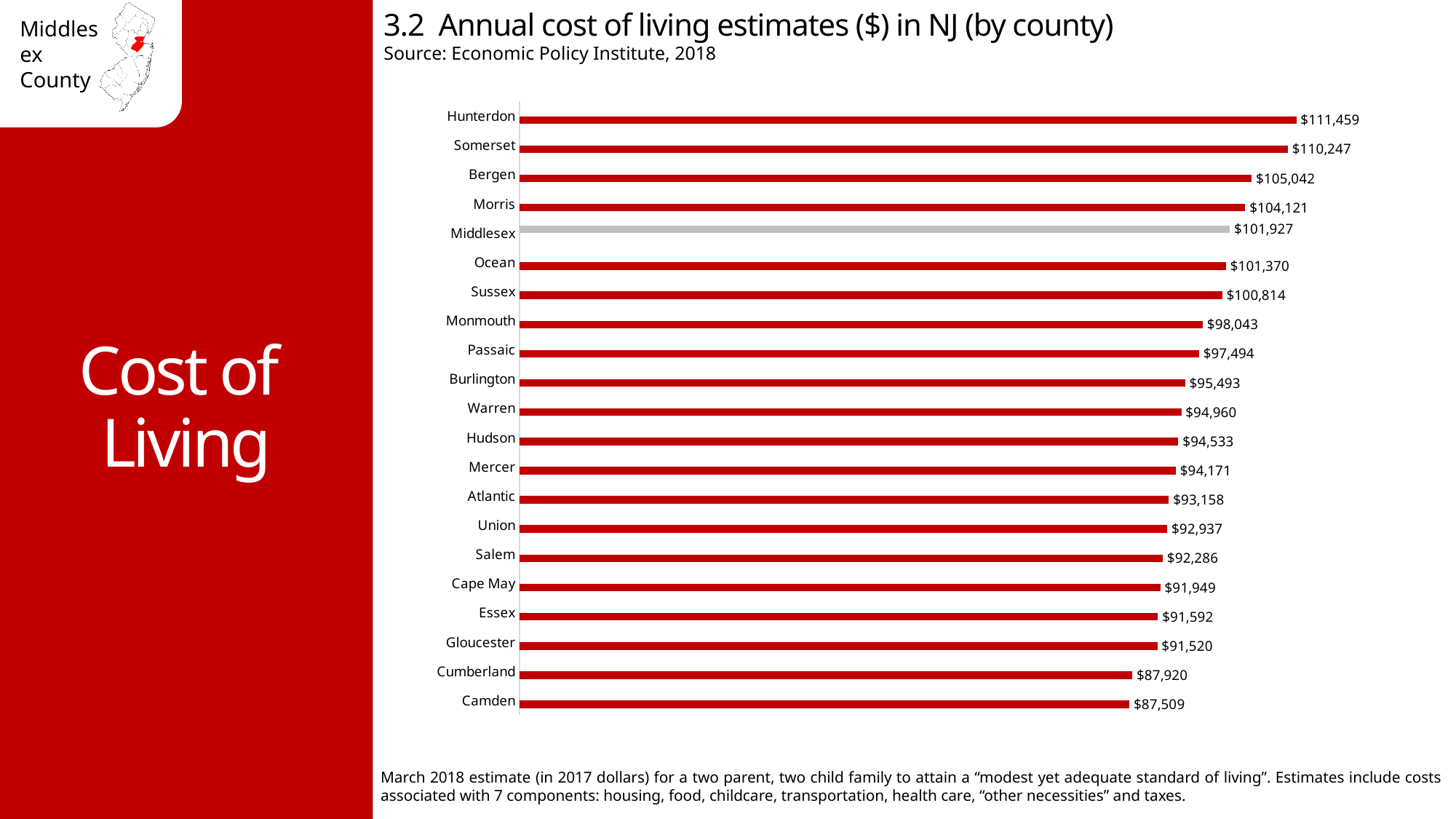
Which county's bar is shown in grey rather than red? Middlesex Which has a higher cost of living estimate, Essex or Monmouth? Monmouth What is the annual cost of living estimate for Camden County? $87,509 How many counties are shown in the chart? 21 What is the annual cost of living estimate for Hunterdon County? $111,459 Which county has the lowest annual cost of living estimate? Camden Which county has the highest annual cost of living estimate? Hunterdon What is the difference between the cost of living estimates for Hunterdon and Camden? $23,950 What is the difference between the cost of living estimates for Middlesex and Ocean? $557 Which has a higher cost of living estimate, Bergen or Morris? Bergen What is the annual cost of living estimate for Middlesex County? $101,927 What kind of chart is shown on the slide? Bar chart